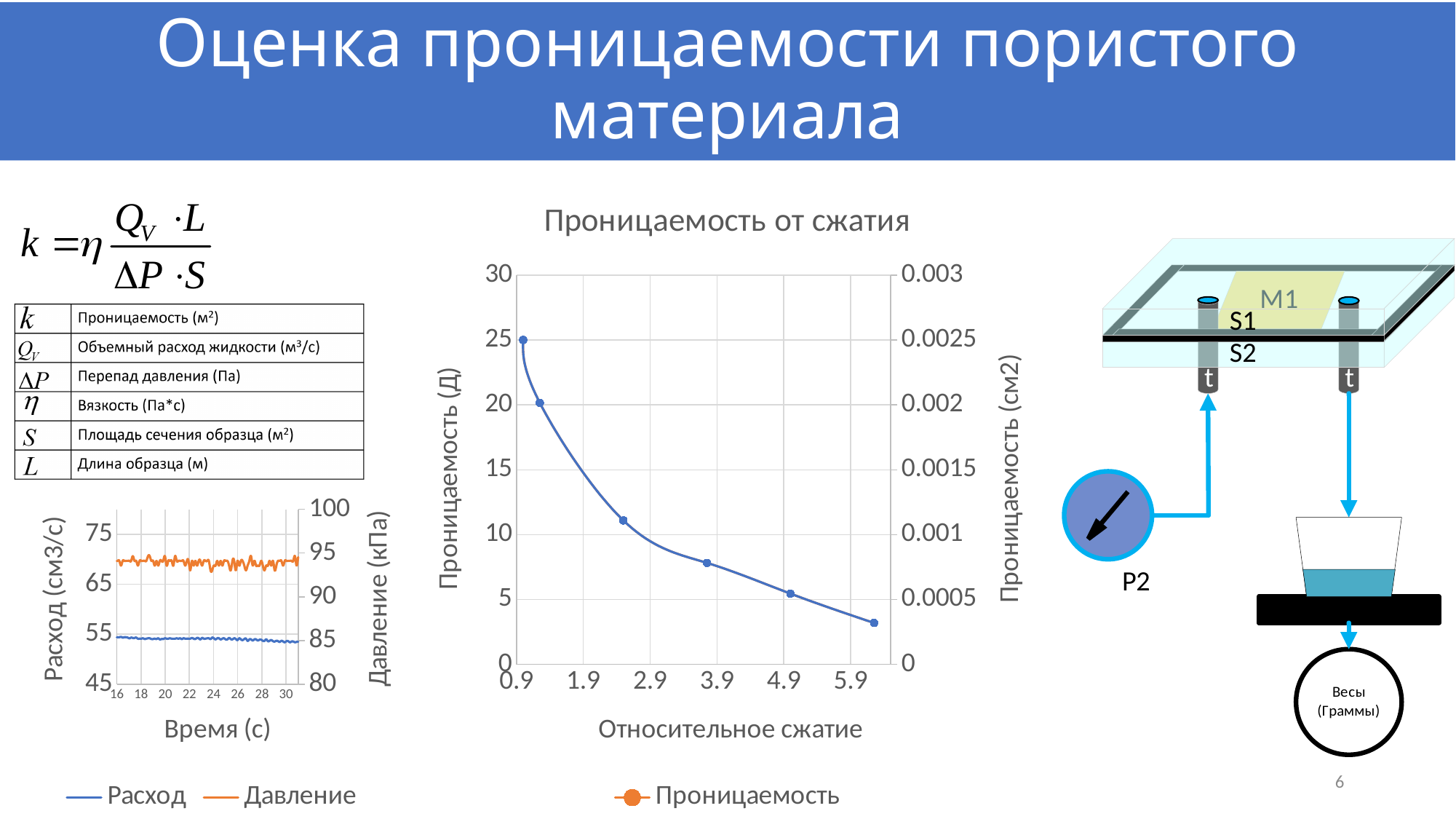
How many data points are plotted on the 'Проницаемость от сжатия' chart? 6 On the 'Проницаемость от сжатия' chart, is the permeability value at the first (leftmost) point greater or less than 20 on the left axis? greater What kind of chart is the 'Проницаемость от сжатия' chart? line chart How many series does the legend of the 'Проницаемость от сжатия' chart list? 1 What kind of chart is the small chart at the bottom left with Расход and Давление? line chart On the small chart at the bottom left, is the Расход value greater or less than 65 on the left axis? less On the small chart at the bottom left, is the Давление value greater or less than 90 on the right axis? greater How many series does the legend of the small chart at the bottom left (Расход/Давление vs Время) list? 2 What is the x-axis label of the 'Проницаемость от сжатия' chart? Относительное сжатие On the 'Проницаемость от сжатия' chart, do the values rise or fall as relative compression increases along the x axis? fall